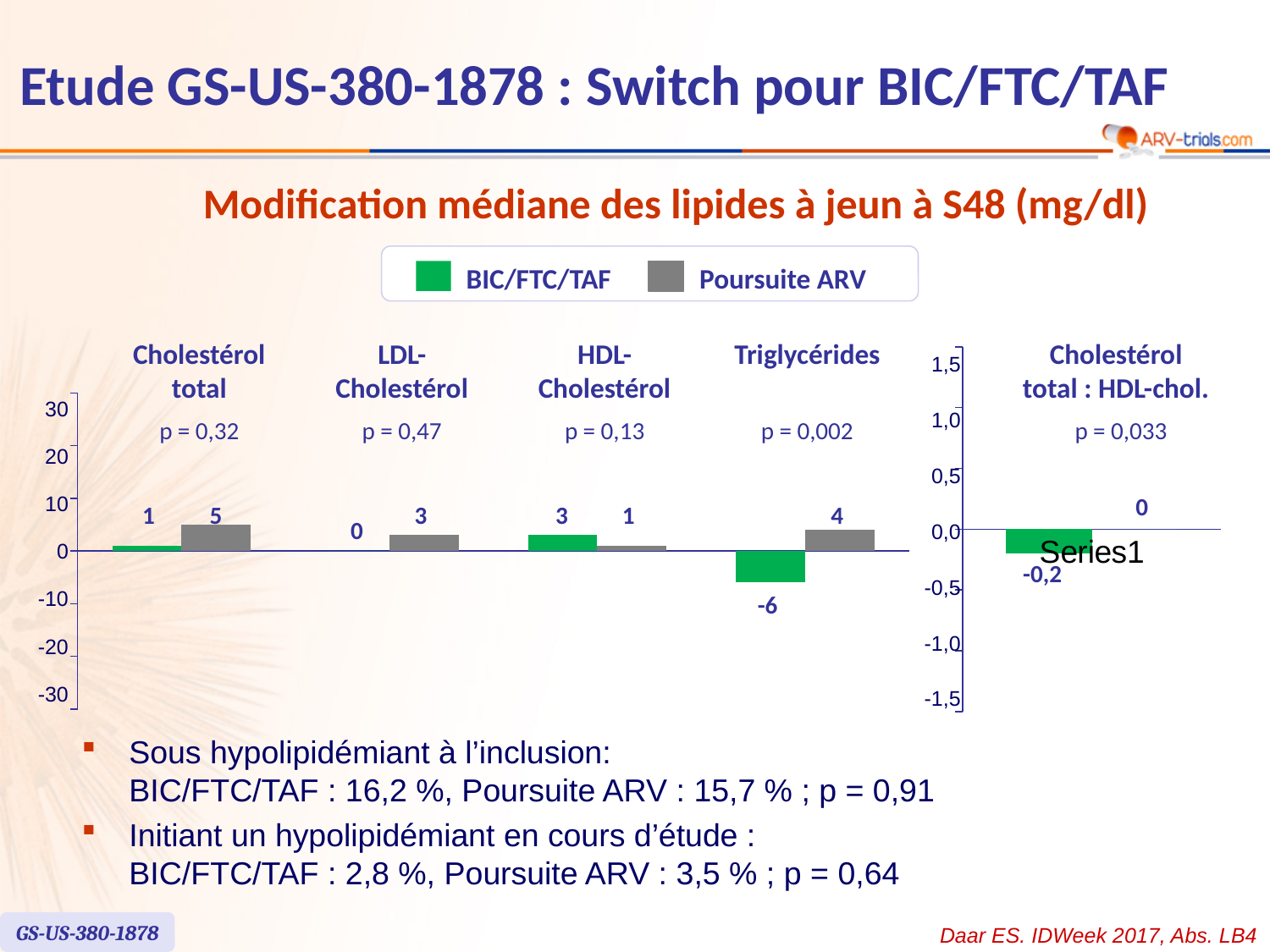
In the left chart, what is the median change in Cholestérol total for BIC/FTC/TAF? 1 In the left chart, what is the median change in Triglycérides for BIC/FTC/TAF? -6 What kind of chart is used to show the median lipid changes? Bar chart In the left chart, what is the median change in Triglycérides for Poursuite ARV? 4 In the left chart, what is the difference between the Poursuite ARV and BIC/FTC/TAF values for Triglycérides? 10 In the left chart, what is the median change in LDL-Cholestérol for BIC/FTC/TAF? 0 In the left chart, which series has the larger value for HDL-Cholestérol, BIC/FTC/TAF or Poursuite ARV? BIC/FTC/TAF How many series does the legend list? 2 In the left chart, which category has the lowest value for BIC/FTC/TAF? Triglycérides In the left chart, which category has the highest value for Poursuite ARV? Cholestérol total In the left chart, what is the median change in Cholestérol total for Poursuite ARV? 5 In the right chart (Cholestérol total : HDL-chol.), what is the value for BIC/FTC/TAF? -0,2